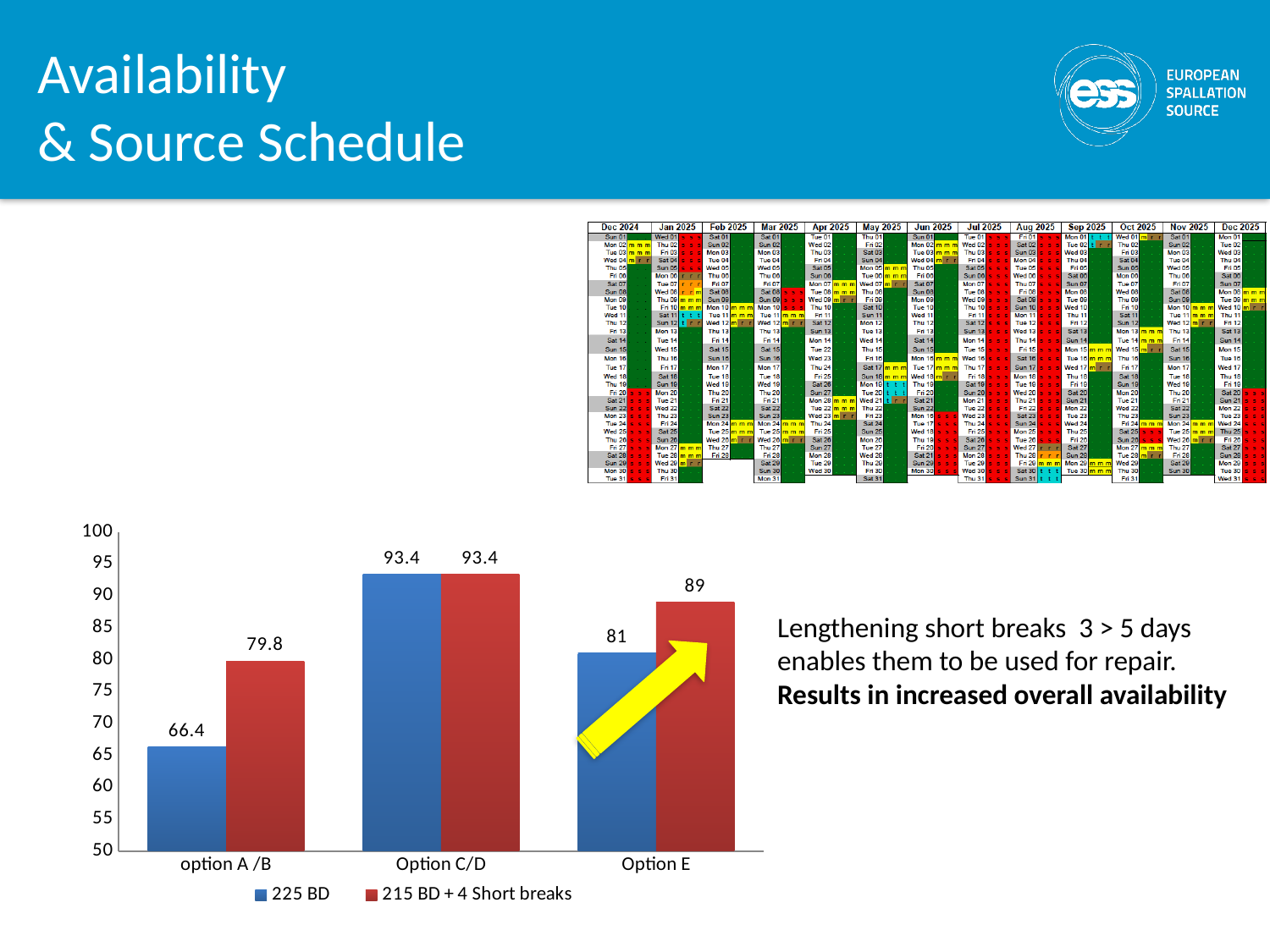
What kind of chart is shown at the bottom left of the slide? bar chart Which category has the lowest value in the 225 BD series? option A /B What is the value for Option C/D in the 225 BD series? 93.4 How many categories are shown on the x axis of the bar chart? 3 How many series does the legend of the bar chart list? 2 What is the difference between the 215 BD + 4 Short breaks value and the 225 BD value for Option E? 8 Which category has the highest value in the 215 BD + 4 Short breaks series? Option C/D What is the value for option A /B in the 225 BD series? 66.4 For Option E, which series has the larger value, 225 BD or 215 BD + 4 Short breaks? 215 BD + 4 Short breaks What is the difference between the 215 BD + 4 Short breaks value and the 225 BD value for option A /B? 13.4 What is the value for option A /B in the 215 BD + 4 Short breaks series? 79.8 What is the value for Option E in the 215 BD + 4 Short breaks series? 89